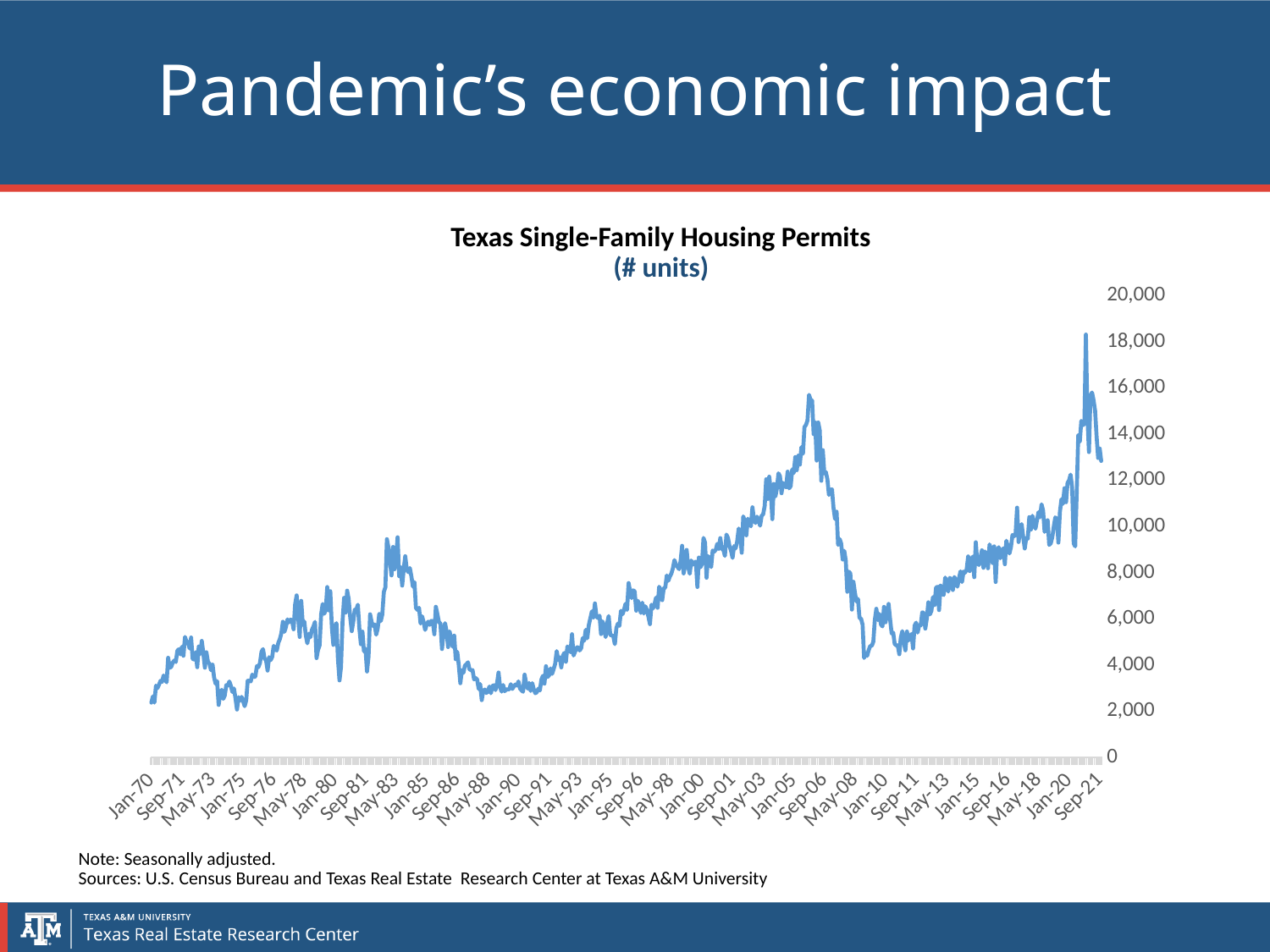
Does the line generally rise or fall between 2006 and 2010? fall Does the line generally rise or fall between 2010 and 2020? rise Is the value at the start of the series, around Jan-70, greater or less than 4,000? less What kind of chart is shown on the slide? line chart Is the highest value reached by the line, near the end of the series in 2021, greater or less than 16,000? greater What is the title of the chart? Texas Single-Family Housing Permits Is the peak reached around 2006 greater or less than 14,000? greater Which is larger: the peak around 2006 or the peak around 2021? the peak around 2021 What is the highest value shown on the vertical axis? 20,000 In what units are the values on the chart expressed, according to the subtitle? # units